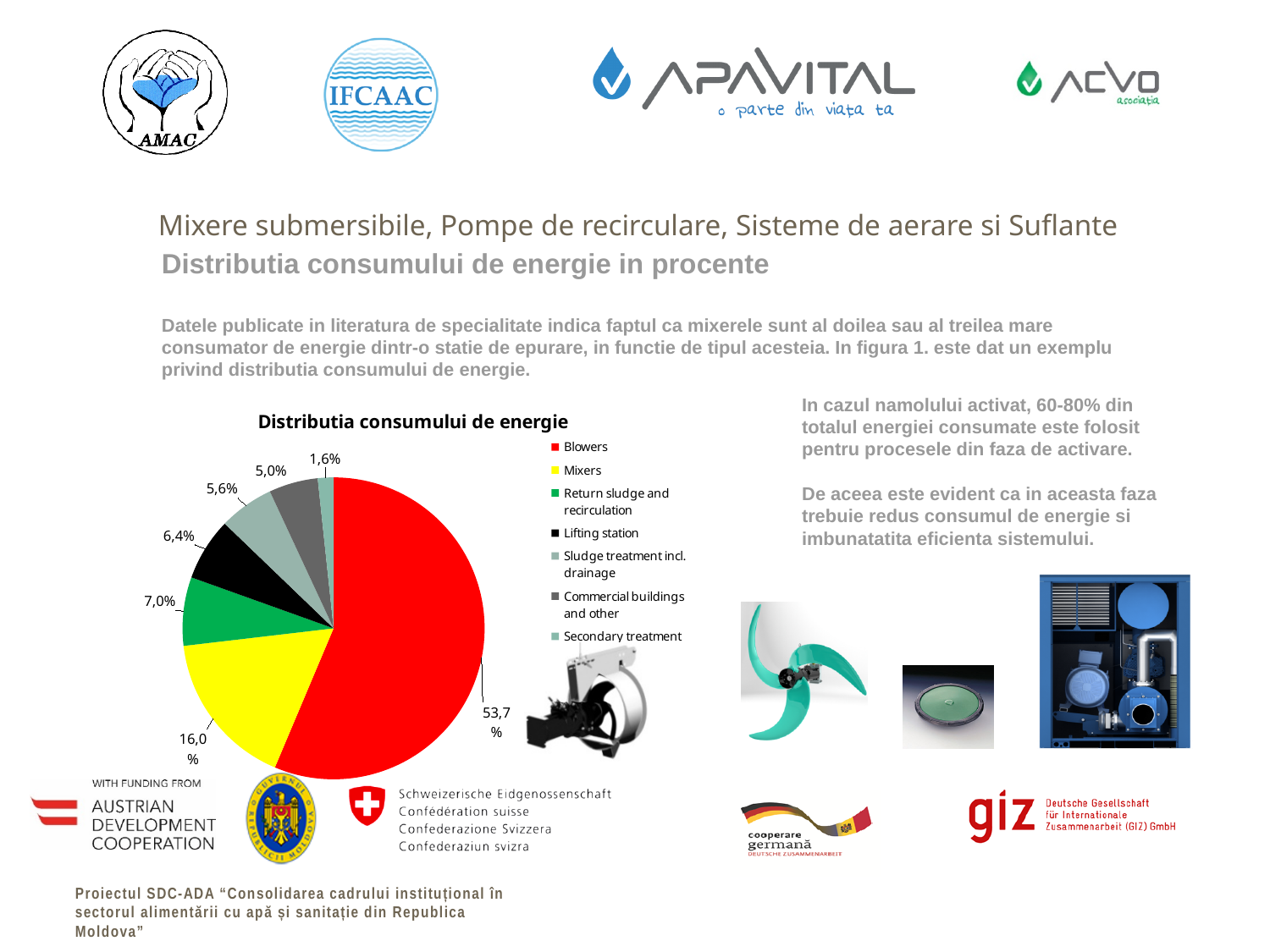
Which category has the largest share of energy consumption? Blowers What share of energy consumption is attributed to Secondary treatment? 1,6% What share of energy consumption is attributed to Mixers? 16,0% How many entries does the legend list? 7 What is the difference in percentage points between the Blowers share and the Mixers share? 37,7 How many slices does the pie chart have? 7 What kind of chart is shown on the slide? pie chart Which has a larger share, Return sludge and recirculation or Sludge treatment incl. drainage? Return sludge and recirculation Which category has the smallest share of energy consumption? Secondary treatment What share of energy consumption is attributed to Blowers? 53,7% What is the title of the chart? Distributia consumului de energie What share of energy consumption is attributed to Lifting station? 6,4%